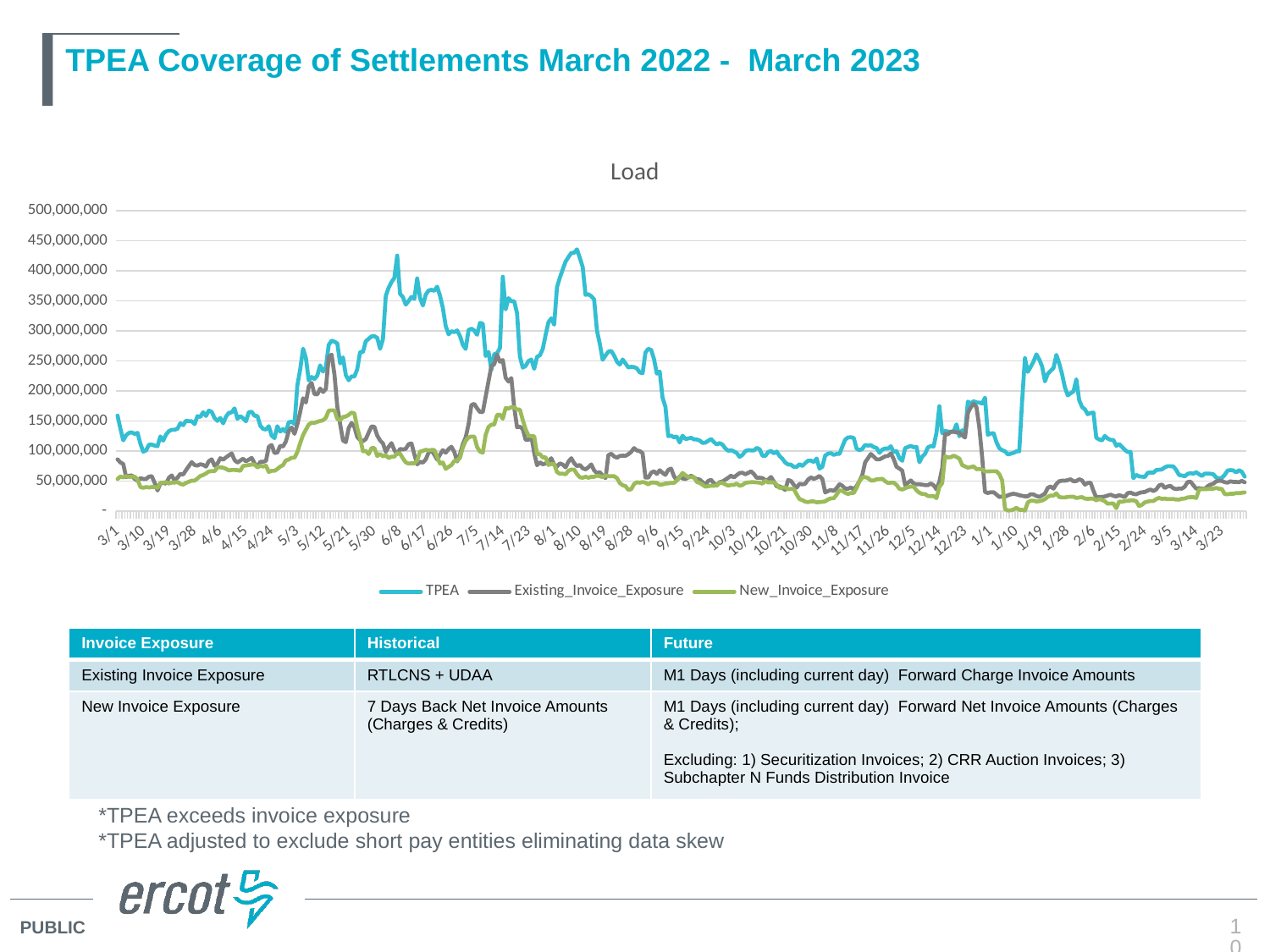
Is the peak Existing_Invoice_Exposure value around 5/12 greater or less than 200,000,000? greater What are the three series named in the chart legend? TPEA, Existing_Invoice_Exposure, New_Invoice_Exposure Does the TPEA line rise or fall between 8/10 and 9/15? Fall What is the title of the chart? Load Around 8/10, which is higher, TPEA or Existing_Invoice_Exposure? TPEA Is the TPEA value around 1/19 greater or less than 200,000,000? greater Which series reaches the highest value anywhere on the chart? TPEA Is the TPEA value at 3/1 greater or less than 200,000,000? less How many series does the chart legend list? 3 What kind of chart is shown on the slide? Line chart